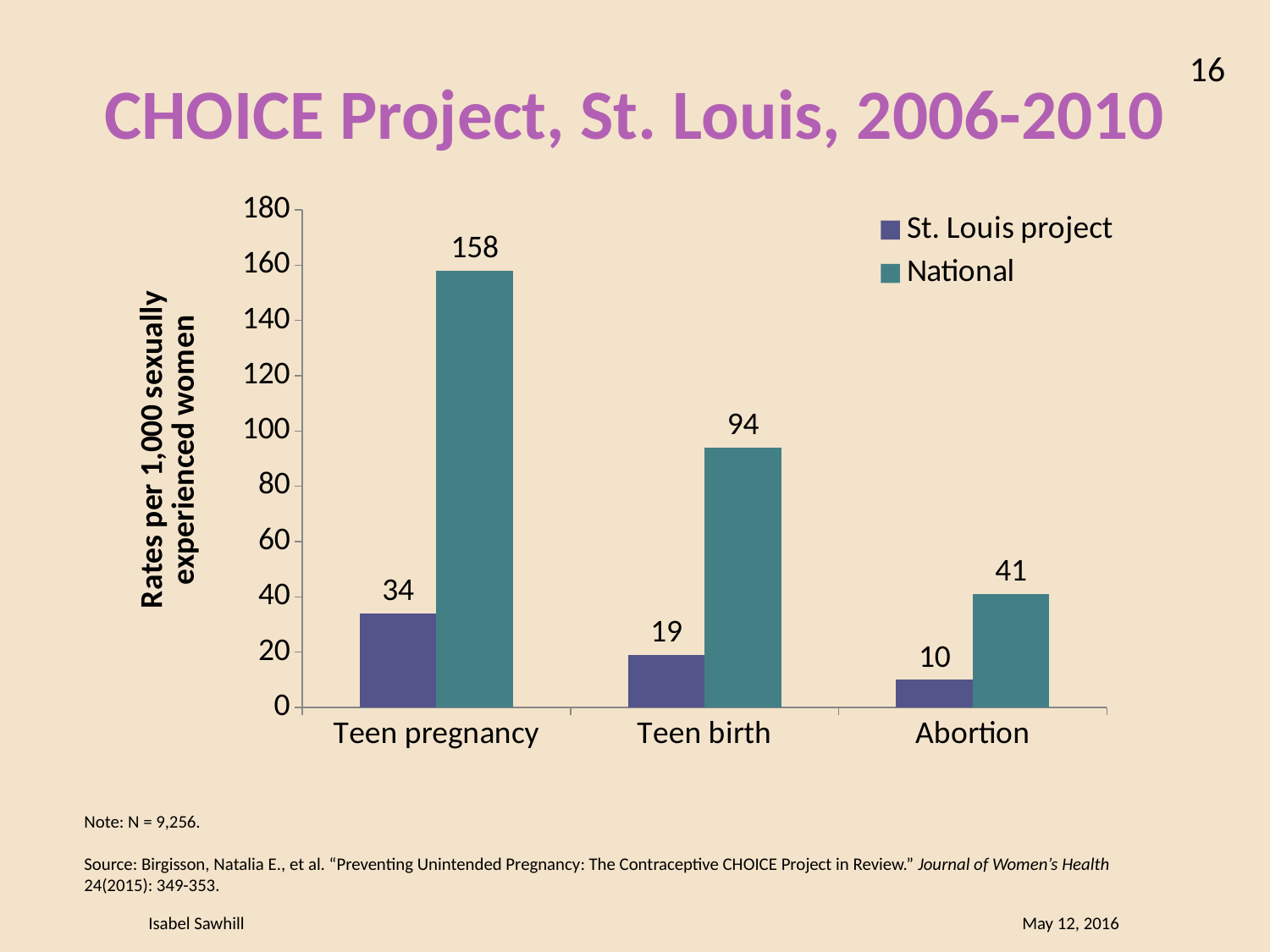
Which category has the highest National rate? Teen pregnancy What is the St. Louis project rate for Teen birth? 19 Is the National rate for Teen birth greater or less than 80? greater How many series does the legend list? 2 What is the National rate for Teen pregnancy? 158 What kind of chart is shown on the slide? Bar chart What is the difference between the National and St. Louis project rates for Teen pregnancy? 124 How many categories are shown on the x axis? 3 What is the St. Louis project rate for Abortion? 10 Which is larger, the St. Louis project rate for Teen pregnancy or the National rate for Abortion? National rate for Abortion What is the difference between the National and St. Louis project rates for Abortion? 31 Which category has the lowest St. Louis project rate? Abortion